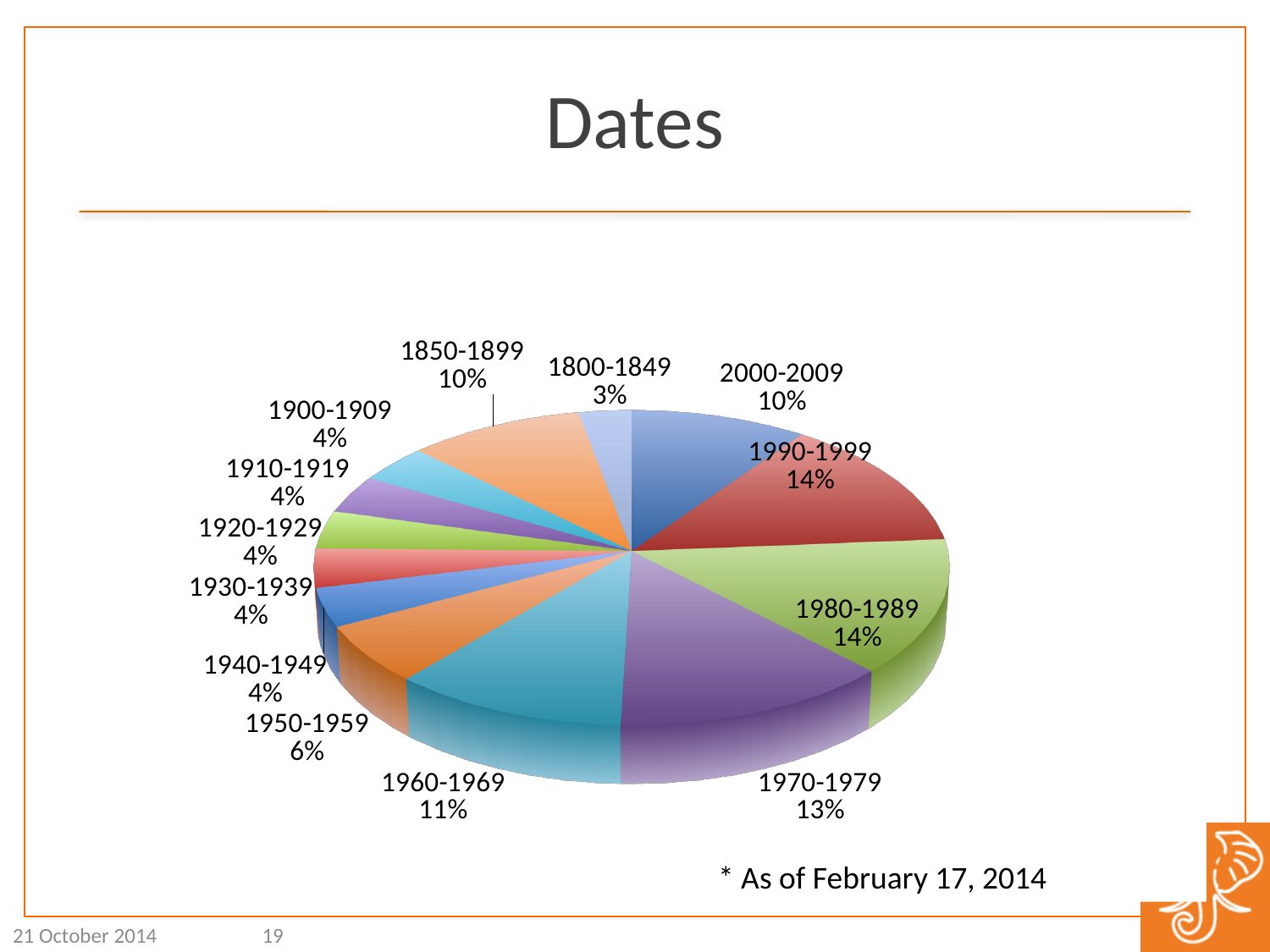
How many slices does the pie chart have? 13 What percentage is shown for 1930-1939? 4% Which is larger, the share for 1970-1979 or the share for 1960-1969? 1970-1979 What share of the pie does the 1970-1979 slice represent? 13% What percentage is shown for 1950-1959? 6% What is the difference between the share for 2000-2009 and the share for 1800-1849? 7% Which date range has the smallest share of the pie? 1800-1849 What percentage is shown for 1960-1969? 11% What is the difference between the share for 1980-1989 and the share for 1950-1959? 8% What kind of chart is shown on the slide? pie chart What is the title of the chart on the slide? Dates What percentage is shown for 1850-1899? 10%